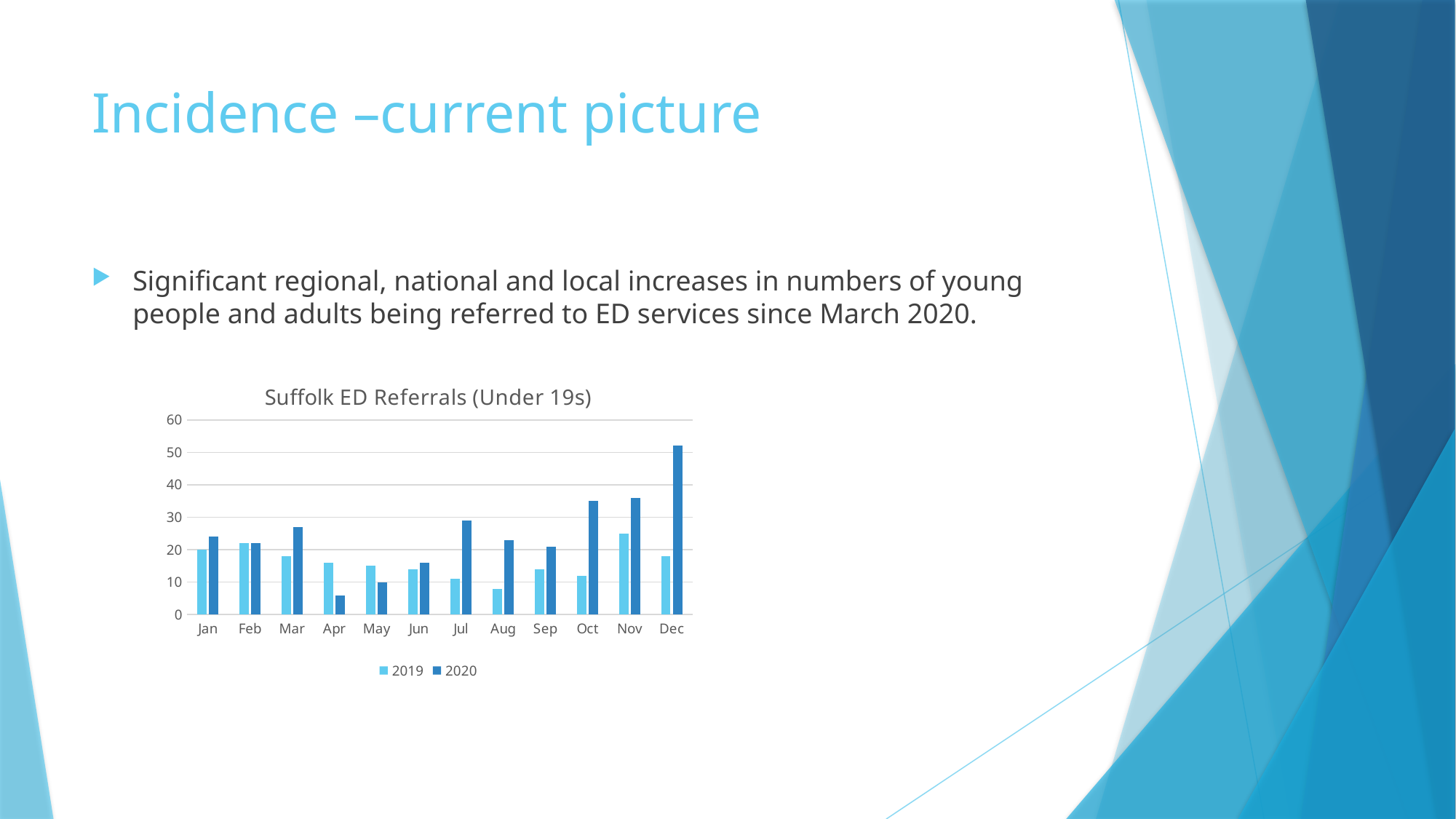
Which month has the highest value for the 2020 series? Dec In Dec, which series has the larger value, 2019 or 2020? 2020 Is the value for Dec in the 2020 series greater or less than 40? greater How many series does the legend list? 2 Which month has the lowest value for the 2019 series? Aug What kind of chart is shown on the slide? bar chart In Apr, which series has the larger value, 2019 or 2020? 2019 What is the title of the chart? Suffolk ED Referrals (Under 19s) Which month has the highest value for the 2019 series? Nov Which month has the lowest value for the 2020 series? Apr How many months are shown on the x axis? 12 Is the value for Apr in the 2020 series greater or less than 10? less